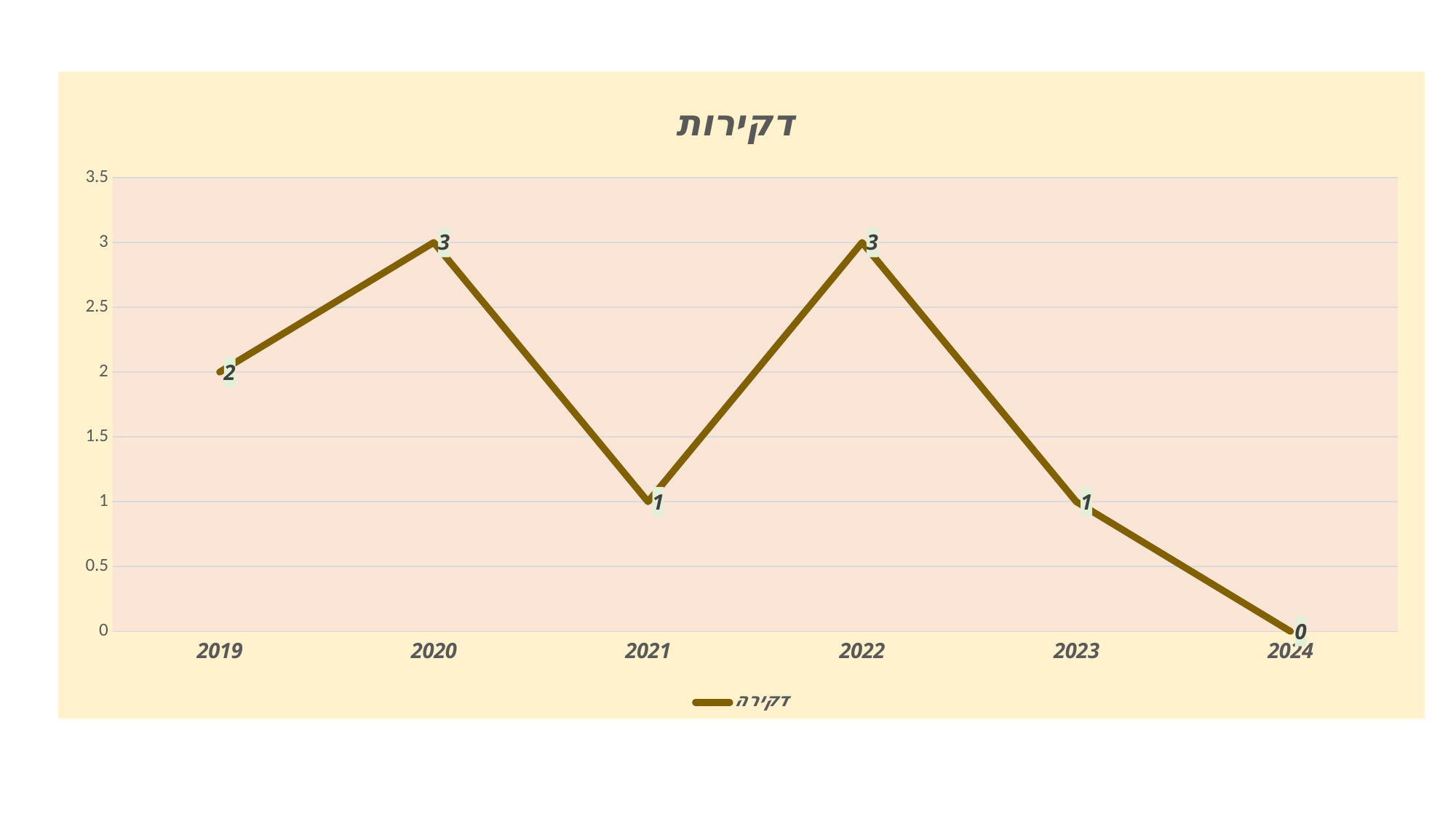
What is the value for 2024? 0 How many years are plotted on the x axis? 6 What is the legend entry for the plotted series? דקירה Which year has the lowest value? 2024 What is the value for 2019? 2 What kind of chart is shown? line chart Does the value rise or fall from 2022 to 2024? fall What is the title of the chart? דקירות What is the difference between the values for 2020 and 2021? 2 What is the value for 2021? 1 How many series does the legend list? 1 Which is larger, the value for 2019 or the value for 2023? 2019